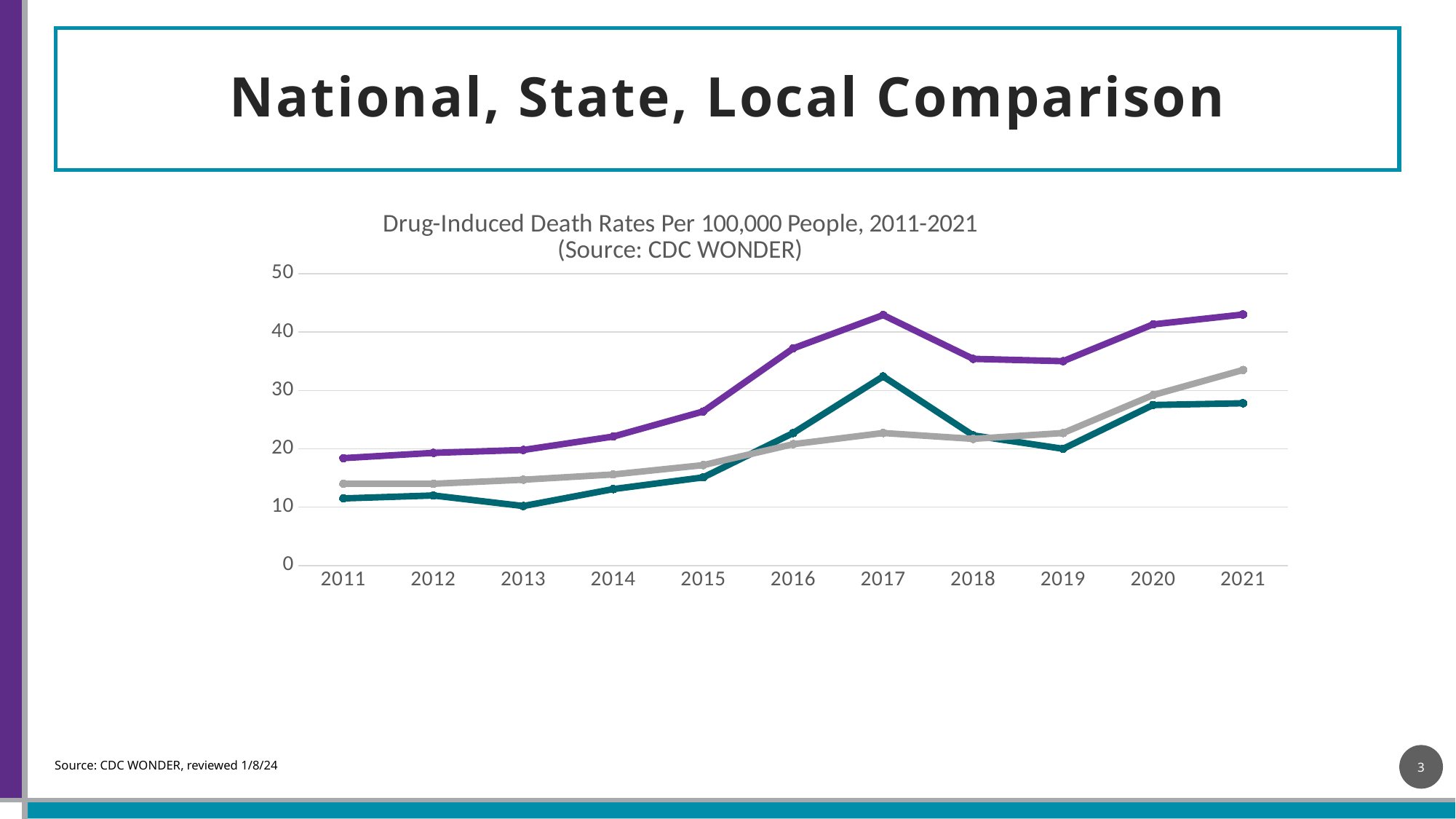
Is the value of the purple line in 2017 greater or less than 40? greater Does the purple line rise or fall between 2011 and 2017? Rise In which year does the gray line reach its highest value? 2021 How many years are shown on the x axis of the chart? 11 In 2021, which line has the larger value, the gray line or the teal line? Gray line Is the value of the gray line in 2021 greater or less than 30? greater In which year does the teal line reach its highest value? 2017 Is the value of the purple line in 2011 greater or less than 20? less What is the title of the chart? Drug-Induced Death Rates Per 100,000 People, 2011-2021 (Source: CDC WONDER) What kind of chart is shown on the slide? Line chart How many lines are plotted on the chart? 3